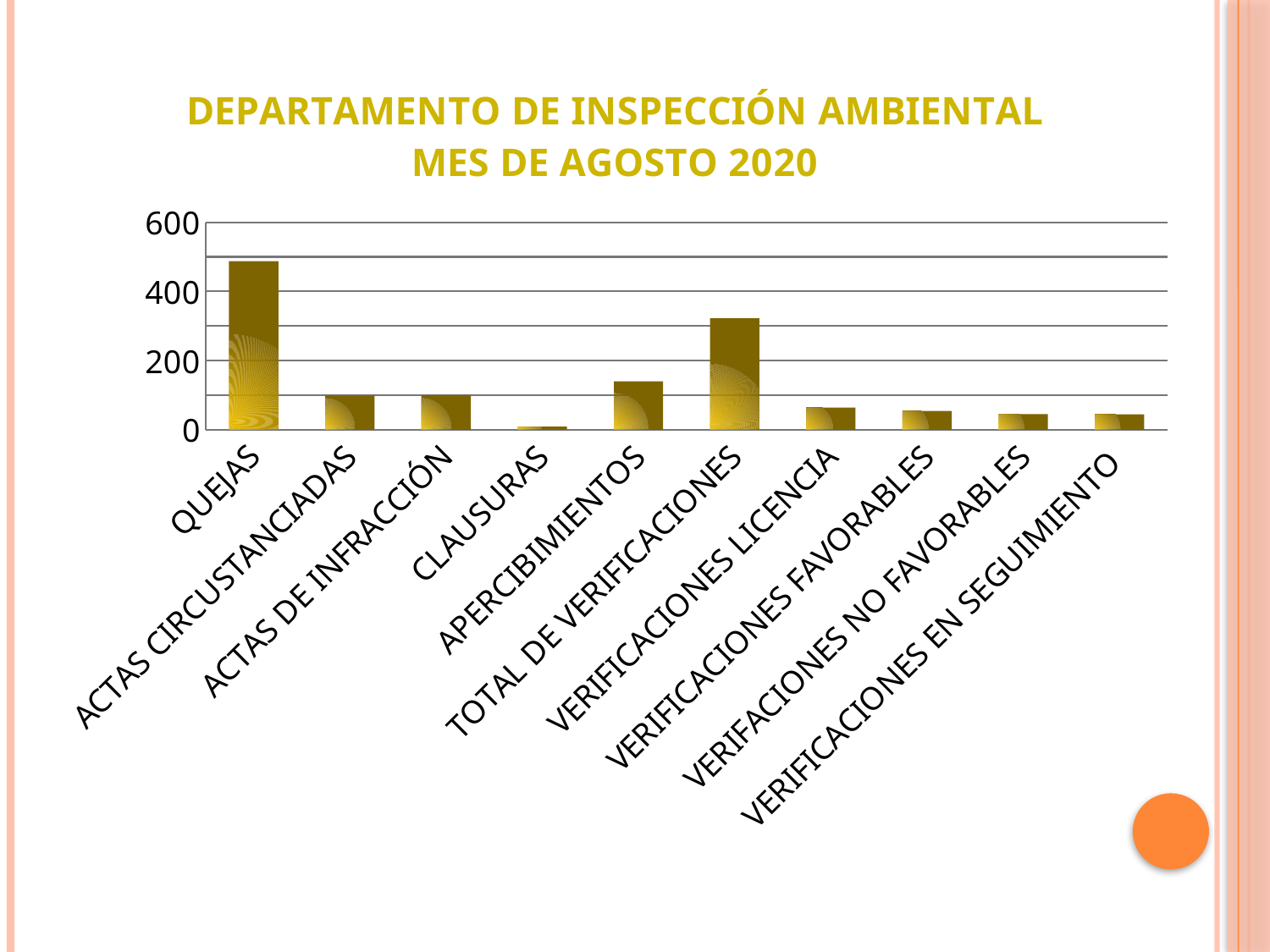
Is the value for TOTAL DE VERIFICACIONES greater or less than 400? less What is the title of the chart on the slide? DEPARTAMENTO DE INSPECCIÓN AMBIENTAL MES DE AGOSTO 2020 Which category has the highest bar in the chart? QUEJAS Which is larger, the value for QUEJAS or the value for TOTAL DE VERIFICACIONES? QUEJAS Which is larger, the value for APERCIBIMIENTOS or the value for CLAUSURAS? APERCIBIMIENTOS What kind of chart is shown on the slide? bar chart Is the value for VERIFICACIONES LICENCIA greater or less than 200? less Is the value for APERCIBIMIENTOS greater or less than 200? less How many categories are plotted on the x axis of the chart? 10 Which category has the lowest bar in the chart? CLAUSURAS